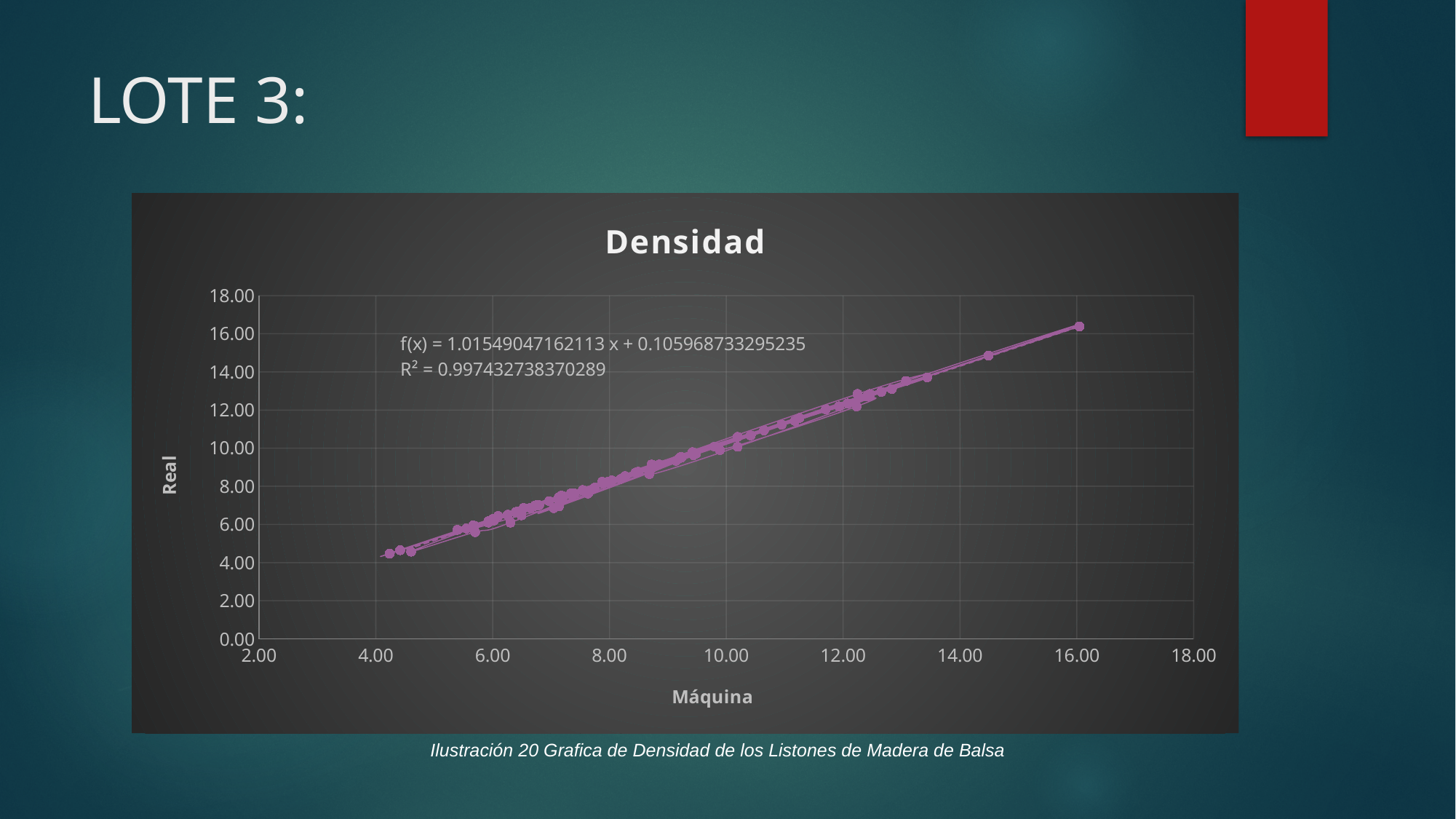
Is the Real value of the leftmost point (at Máquina about 4) greater or less than 6? less Do the Real values rise or fall as the Máquina values increase along the x axis? rise What is the intercept of the trendline equation printed on the chart? 0.105968733295235 What kind of chart is shown on the slide? scatter chart What is the R² value printed on the chart? 0.997432738370289 What is the title of the chart? Densidad What is the label of the horizontal axis of the chart? Máquina Is the Real value of the point at Máquina about 14.5 greater or less than 12? greater Is the Real value of the rightmost point (at Máquina about 16) greater or less than 14? greater What is the slope of the trendline equation printed on the chart? 1.01549047162113